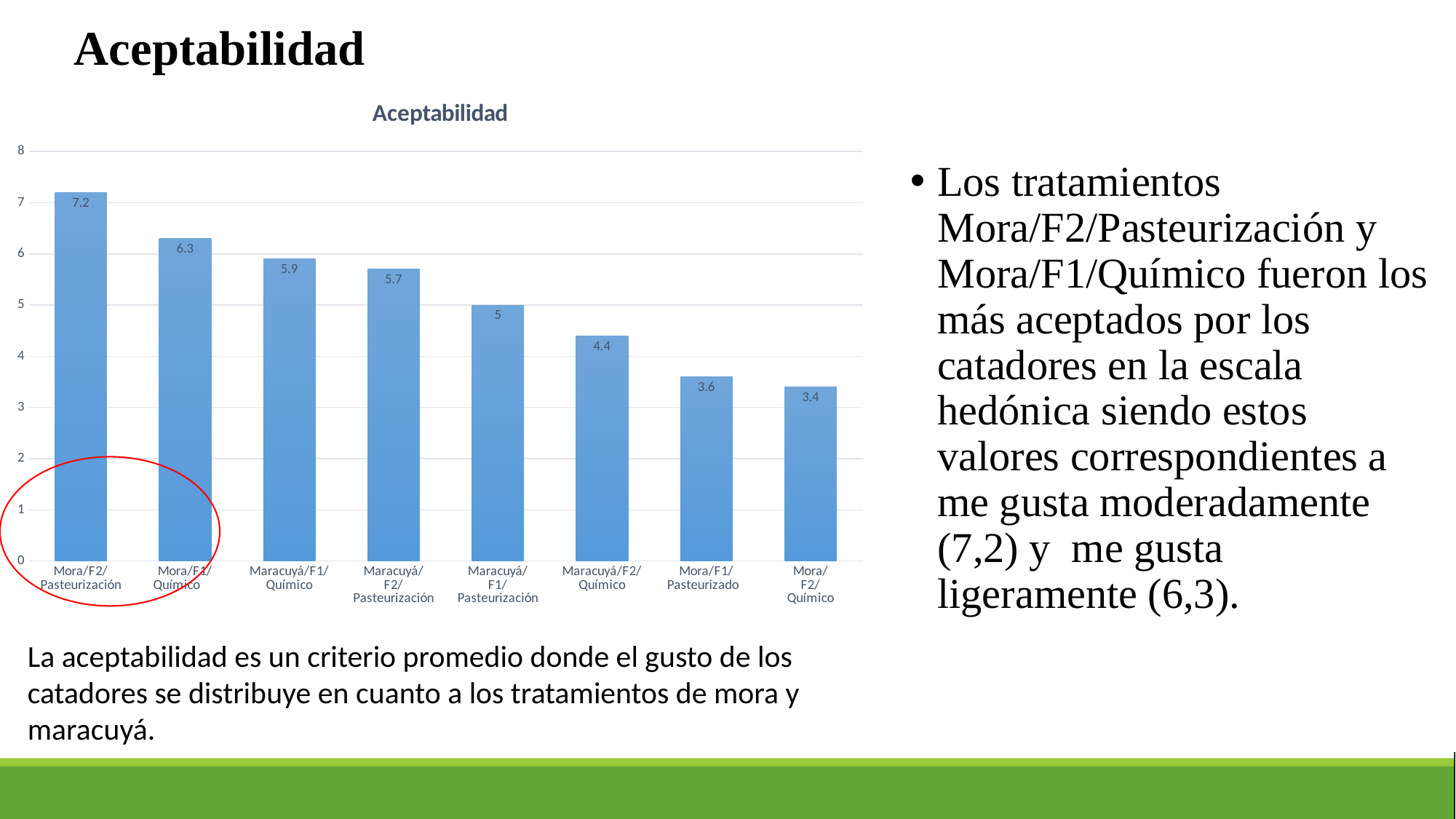
What is the value for Mora/F1/Pasteurizado? 3.6 What is the difference between the values for Mora/F2/Pasteurización and Mora/F1/Químico? 0.9 What is the value for Mora/F2/Pasteurización? 7.2 What kind of chart is shown? bar chart Is the value for Maracuyá/F1/Químico greater or less than 5? greater What is the value for Maracuyá/F2/Químico? 4.4 Which category has the highest value? Mora/F2/Pasteurización What is the difference between the values for Maracuyá/F1/Químico and Mora/F2/Químico? 2.5 Do the values rise or fall from left to right along the x axis? fall Which is larger, the value for Maracuyá/F2/Pasteurización or the value for Maracuyá/F1/Pasteurización? Maracuyá/F2/Pasteurización Which category has the lowest value? Mora/F2/Químico How many categories are shown on the x axis? 8